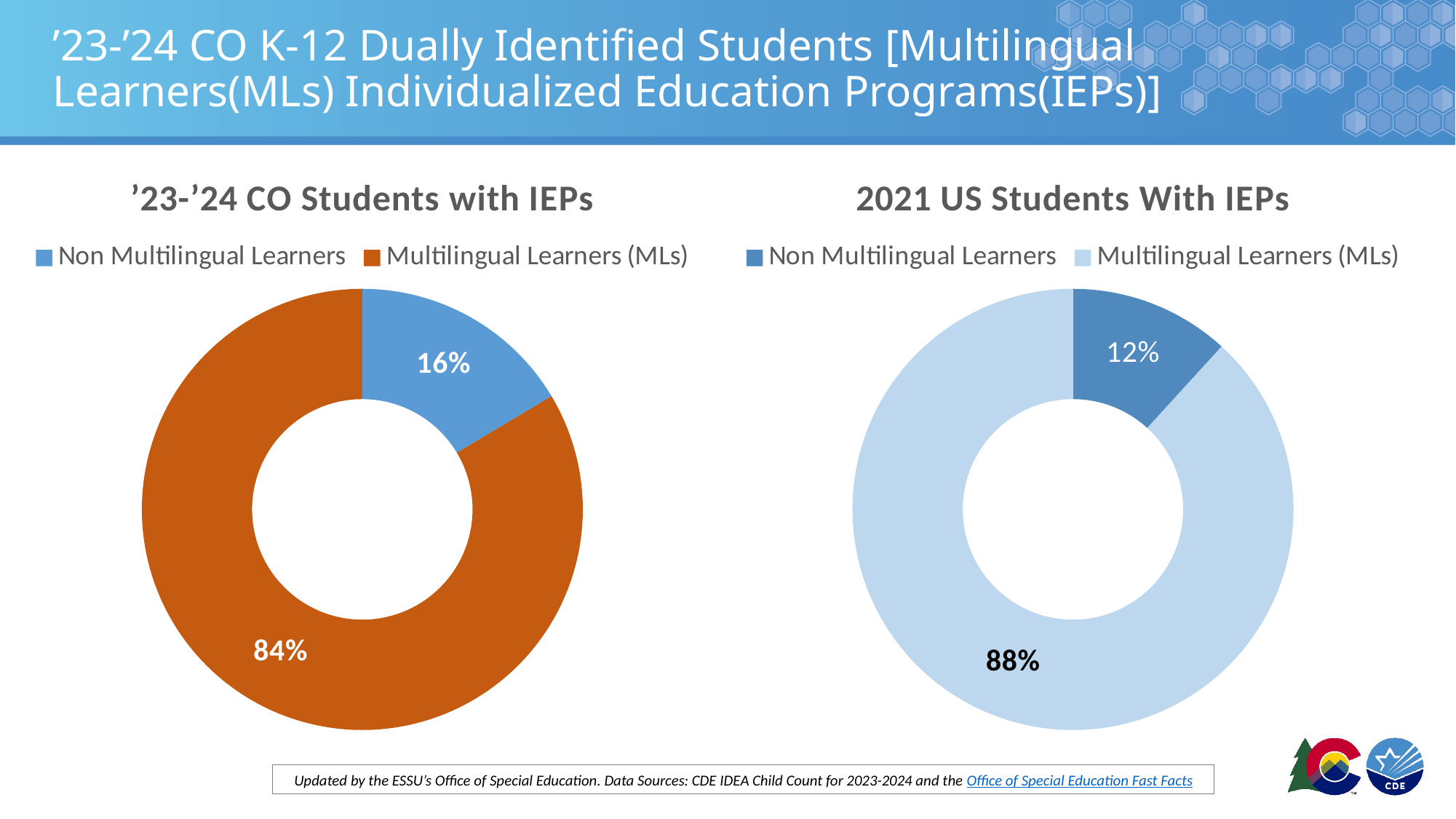
In the '23-'24 CO Students with IEPs chart, what is the difference in percentage points between Multilingual Learners (MLs) and Non Multilingual Learners? 68 In the '23-'24 CO Students with IEPs chart, what percentage is shown for Multilingual Learners (MLs)? 84% In the 2021 US Students With IEPs chart, what percentage is shown for Non Multilingual Learners? 12% How many entries does the legend of the '23-'24 CO Students with IEPs chart list? 2 In the 2021 US Students With IEPs chart, which category has the smallest share? Non Multilingual Learners In the '23-'24 CO Students with IEPs chart, what colour represents Multilingual Learners (MLs)? Orange How many categories does the 2021 US Students With IEPs chart show? 2 Which is larger: the Non Multilingual Learners share in the '23-'24 CO Students with IEPs chart or in the 2021 US Students With IEPs chart? '23-'24 CO Students with IEPs In the 2021 US Students With IEPs chart, what percentage is shown for Multilingual Learners (MLs)? 88% In the '23-'24 CO Students with IEPs chart, which category has the largest share? Multilingual Learners (MLs) What kind of chart is the '23-'24 CO Students with IEPs chart? Donut (pie) chart In the '23-'24 CO Students with IEPs chart, what percentage is shown for Non Multilingual Learners? 16%